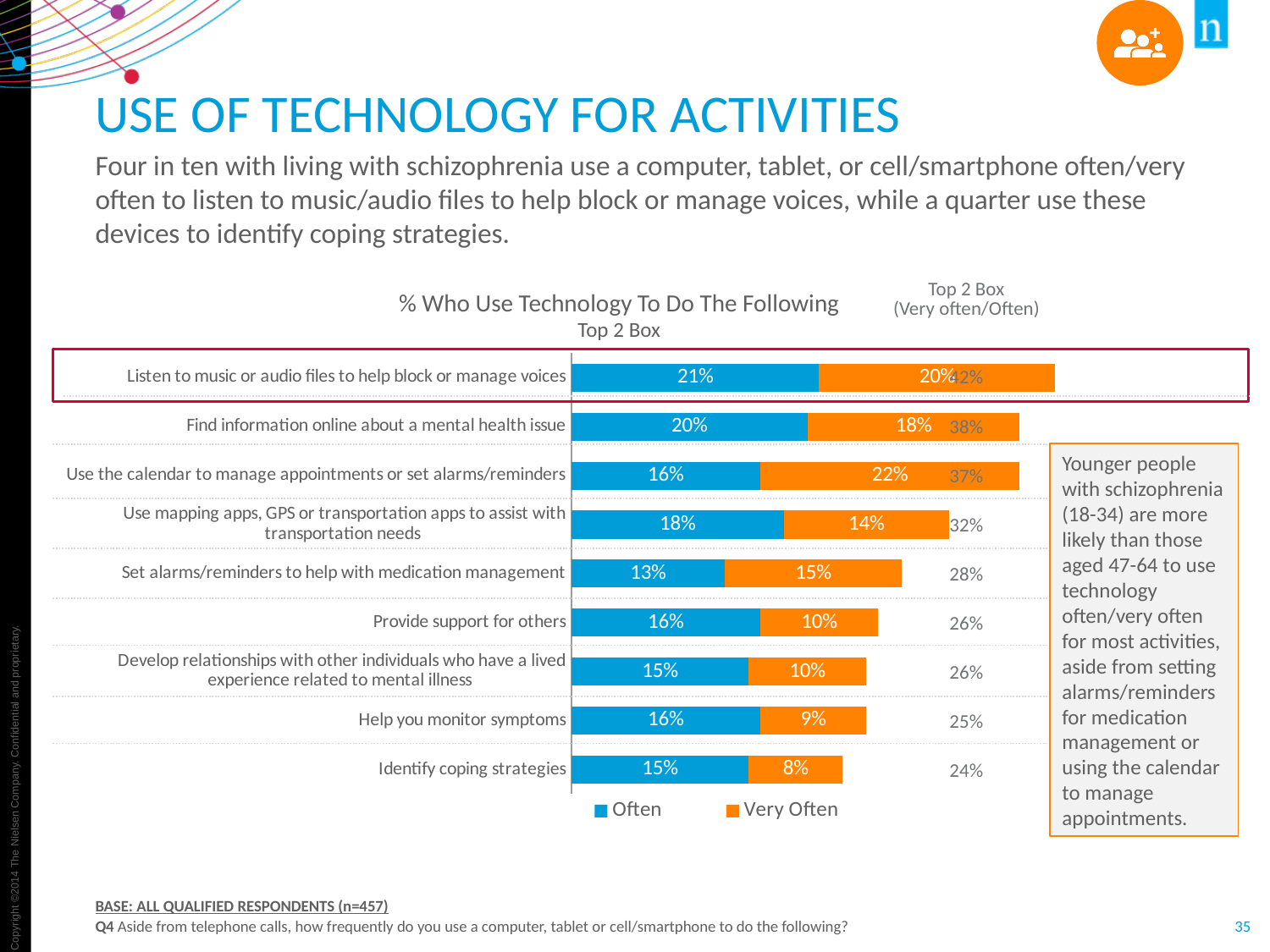
What is the 'Often' value for 'Find information online about a mental health issue'? 20% What kind of chart is shown on the slide? Bar chart Which has a larger 'Often' value: 'Use mapping apps, GPS or transportation apps to assist with transportation needs' or 'Help you monitor symptoms'? Use mapping apps, GPS or transportation apps to assist with transportation needs For 'Provide support for others', what is the difference between the 'Often' and 'Very Often' values? 6% Which activity has the highest 'Very Often' value? Use the calendar to manage appointments or set alarms/reminders How many activities (categories) are plotted in the chart? 9 What is the total of the stacked bar for 'Find information online about a mental health issue'? 38% What are the two legend entries in the chart? Often and Very Often What is the 'Very Often' value for 'Use the calendar to manage appointments or set alarms/reminders'? 22% What is the Top 2 Box value for 'Set alarms/reminders to help with medication management'? 28% How many series does the legend list? 2 Which activity has the lowest 'Very Often' value? Identify coping strategies